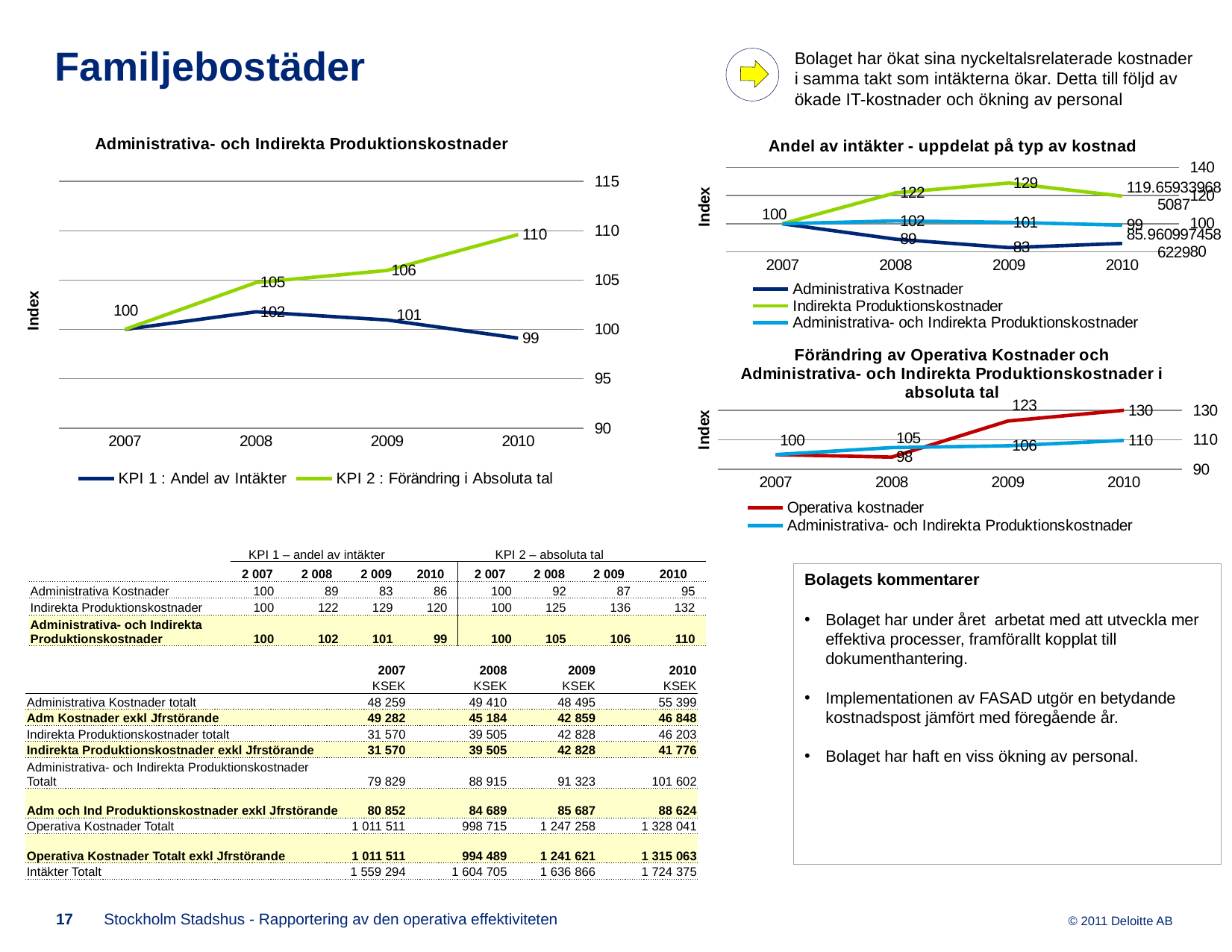
In the chart titled 'Andel av intäkter - uppdelat på typ av kostnad', how many series does the legend list? 3 In the chart titled 'Andel av intäkter - uppdelat på typ av kostnad', which series has the lowest value in 2009? Administrativa Kostnader What kind of chart is 'Andel av intäkter - uppdelat på typ av kostnad'? line chart In the chart titled 'Förändring av Operativa Kostnader och Administrativa- och Indirekta Produktionskostnader i absoluta tal', what is the value of Operativa kostnader in 2010? 130 In the chart titled 'Förändring av Operativa Kostnader och Administrativa- och Indirekta Produktionskostnader i absoluta tal', which series is higher in 2008? Administrativa- och Indirekta Produktionskostnader In the chart titled 'Andel av intäkter - uppdelat på typ av kostnad', what is the value of Indirekta Produktionskostnader in 2009? 129 In the chart titled 'Administrativa- och Indirekta Produktionskostnader', how many series does the legend list? 2 In the chart titled 'Administrativa- och Indirekta Produktionskostnader', does KPI 2 : Förändring i Absoluta tal rise or fall from 2007 to 2010? rise In the chart titled 'Administrativa- och Indirekta Produktionskostnader', what is the value of KPI 2 : Förändring i Absoluta tal in 2010? 110 In the chart titled 'Administrativa- och Indirekta Produktionskostnader', in which year is KPI 1 : Andel av Intäkter lowest? 2010 In the chart titled 'Administrativa- och Indirekta Produktionskostnader', what is the difference between KPI 2 and KPI 1 in 2010? 11 In the chart titled 'Administrativa- och Indirekta Produktionskostnader', what is the value of KPI 1 : Andel av Intäkter in 2009? 101